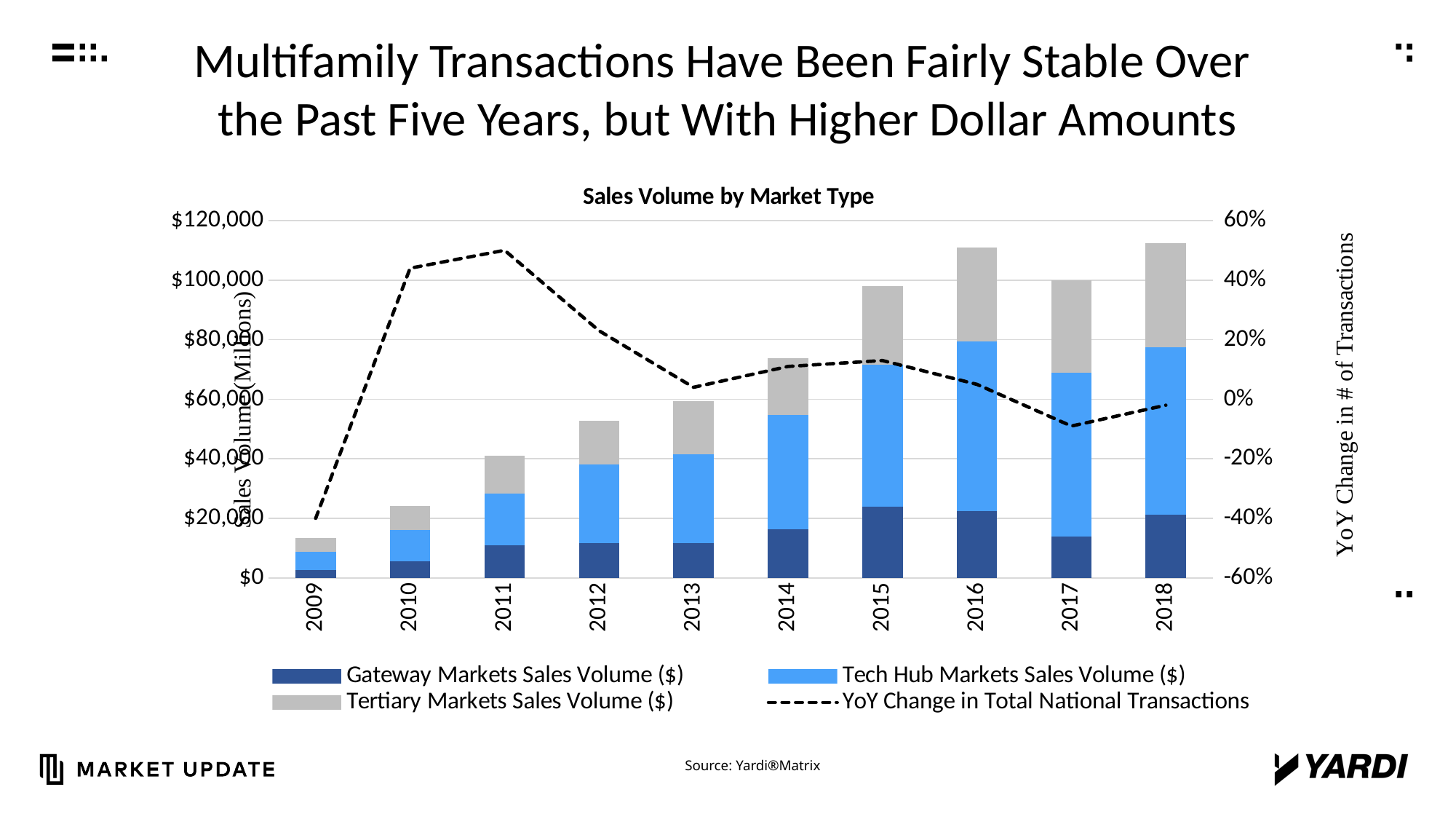
How many series does the legend list? 4 What is the title of the chart? Sales Volume by Market Type Is the total sales volume for 2014 greater or less than $60,000? greater Does the total sales volume rise or fall from 2009 to 2016? rise What kind of chart is this? Bar chart with a line Is the total sales volume for 2009 greater or less than $20,000? less In which year is the YoY Change in Total National Transactions line at its lowest point? 2009 How many years are shown on the x axis? 10 In which year does the YoY Change in Total National Transactions line reach its highest point? 2011 Which year has the lowest total sales volume? 2009 Is the total sales volume for 2015 greater or less than $80,000? greater Which year has the larger total sales volume, 2013 or 2015? 2015